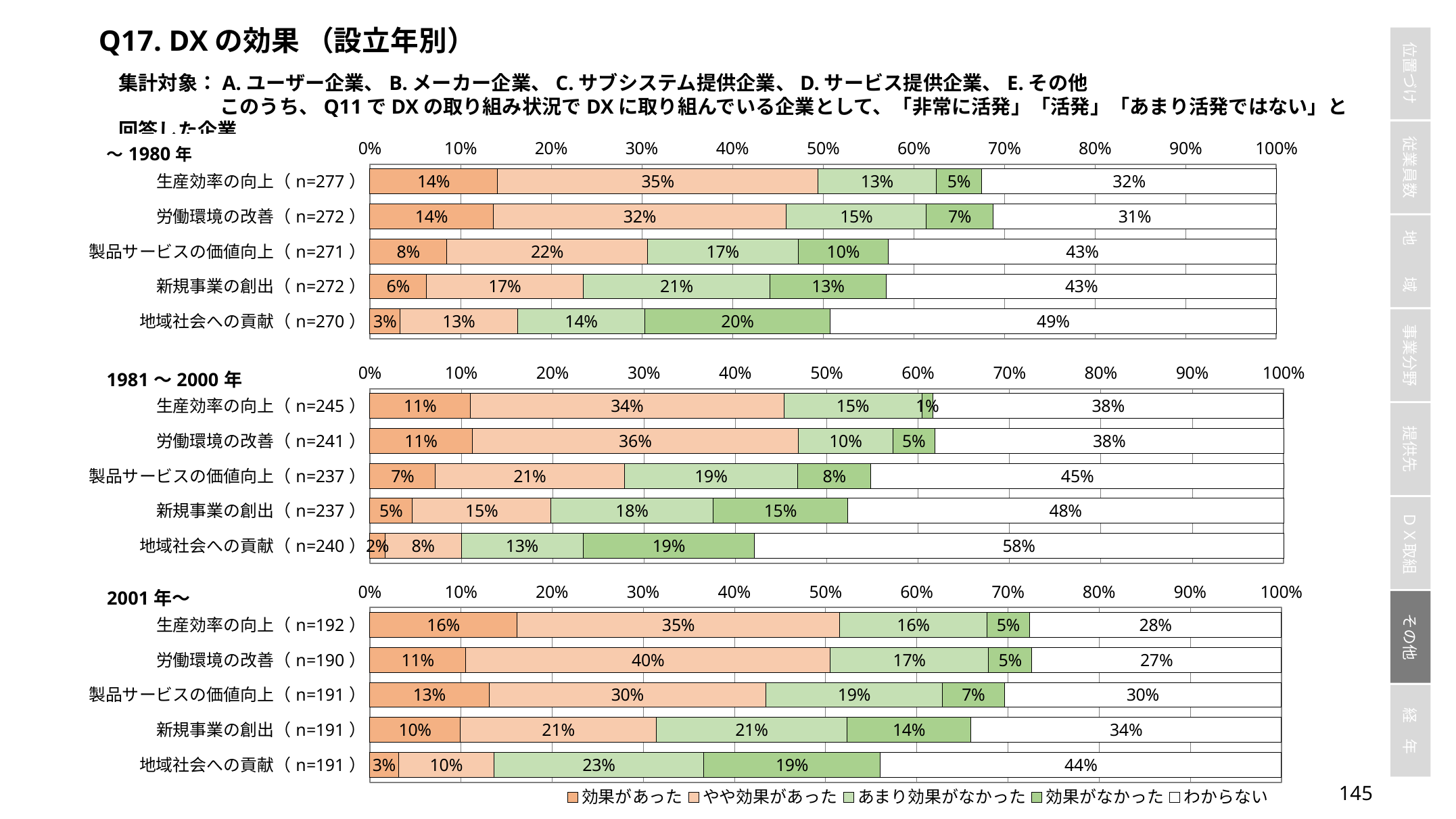
In the 2001年～ chart, which category has the highest value for 効果があった? 生産効率の向上 (n=192) In the ～1980年 chart, which category has the lowest value for 効果があった? 地域社会への貢献 (n=270) What kind of chart is used for the 1981～2000年 group? Stacked bar chart In the 2001年～ chart, what is the value of やや効果があった for 労働環境の改善 (n=190)? 40% In the ～1980年 chart, what is the value of 効果があった for 生産効率の向上 (n=277)? 14% Which legend entry is shown in white? わからない In the 2001年～ chart, what is the combined value of 効果があった and やや効果があった for 製品サービスの価値向上 (n=191)? 43% In the 1981～2000年 chart, what is the value of わからない for 地域社会への貢献 (n=240)? 58% In the 1981～2000年 chart, what is the difference between the わからない values for 新規事業の創出 (n=237) and 生産効率の向上 (n=245)? 10% In the ～1980年 chart, which is larger: the 効果がなかった value for 地域社会への貢献 (n=270) or for 新規事業の創出 (n=272)? 地域社会への貢献 (n=270) How many categories does the 2001年～ chart show? 5 How many series does the legend list? 5